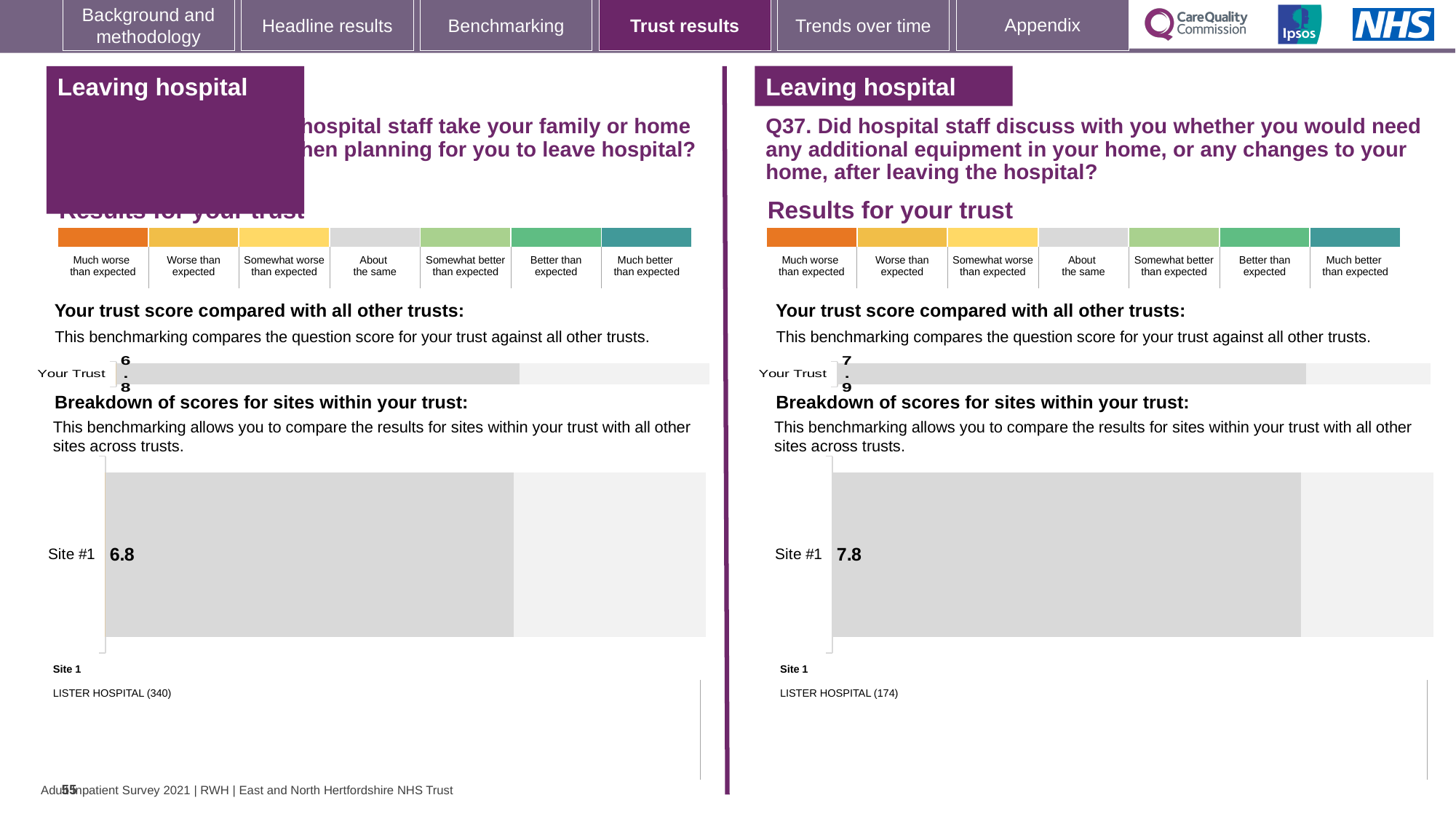
Which Site #1 score is larger: the one on the left half of the slide or the one on the right half (Q37)? The right half (Q37) On the left half of the slide, what is the score shown for Site #1 in the breakdown of scores for sites within your trust? 6.8 How many sites are shown in the breakdown of scores chart on the left half of the slide? 1 What kind of chart is used for the breakdown of scores for sites within your trust on the left half of the slide? Bar chart On the right half of the slide (Q37), which hospital is listed as Site 1 below the breakdown chart? LISTER HOSPITAL (174) On the right half of the slide (Q37), what is the value shown for Your Trust in the trust score comparison chart? 7.9 On the left half of the slide, which hospital is listed as Site 1 below the breakdown chart? LISTER HOSPITAL (340) How many sites are shown in the breakdown of scores chart on the right half of the slide (Q37)? 1 What is the difference between the Site #1 score on the right half of the slide (Q37) and the Site #1 score on the left half? 1.0 On the left half of the slide, what is the value shown for Your Trust in the trust score comparison chart? 6.8 On the right half of the slide (Q37), what is the difference between the Your Trust score and the Site #1 score? 0.1 On the right half of the slide (Q37), what is the score shown for Site #1 in the breakdown of scores for sites within your trust? 7.8